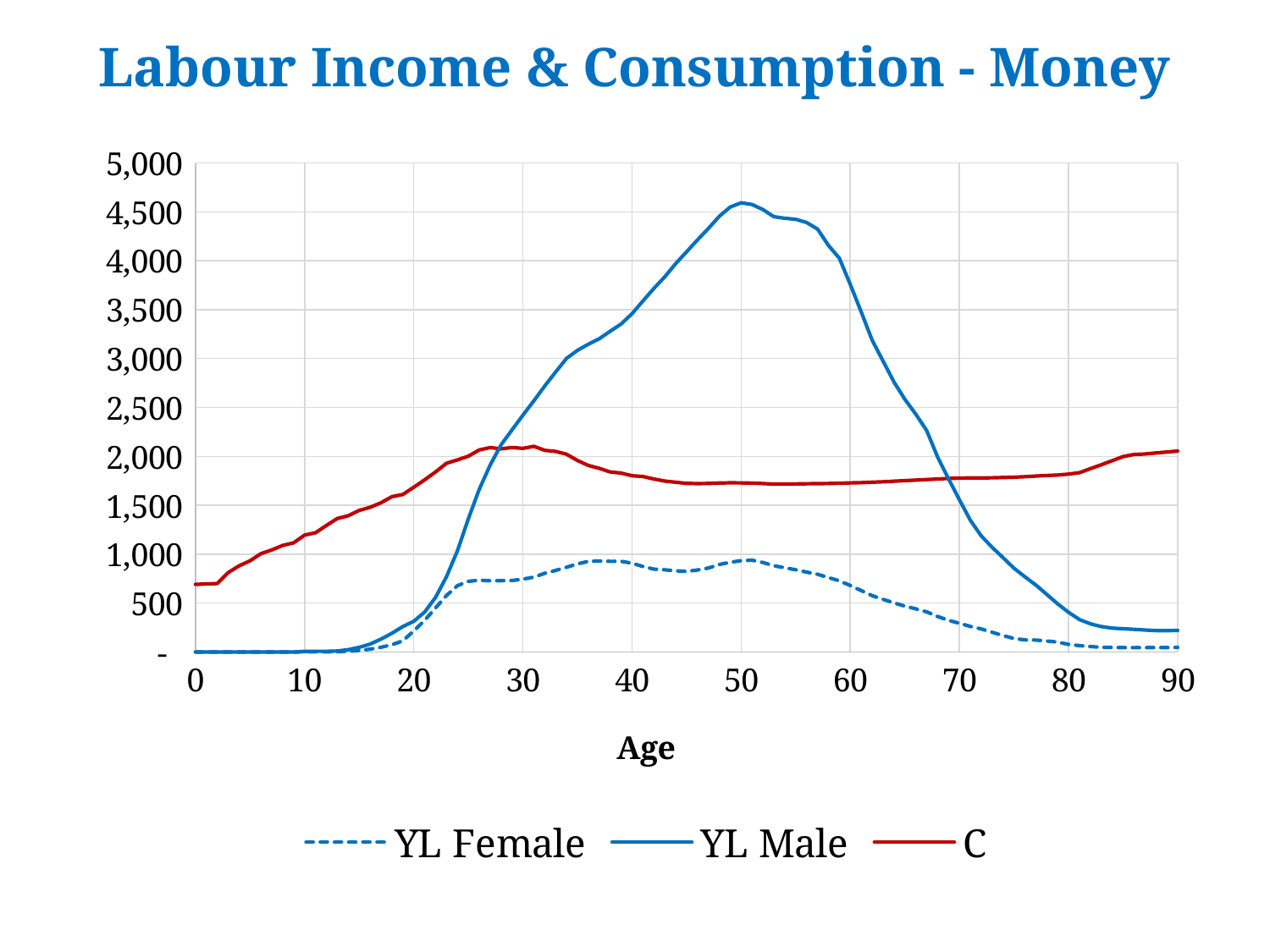
At age 50, which series has the higher value, YL Male or C? YL Male How many series does the legend list? 3 What are the three series named in the legend? YL Female, YL Male, C Which series reaches the highest value anywhere on the chart? YL Male Does the YL Male series rise or fall between age 50 and age 90? fall Is the value of YL Female at age 50 greater or less than 1,500? less Is the value of C at age 0 greater or less than 1,000? less Is the value of YL Male at age 50 greater or less than 4,000? greater What is the title of the chart? Labour Income & Consumption - Money At age 10, which series has the higher value, C or YL Male? C What kind of chart is shown on the slide? line chart